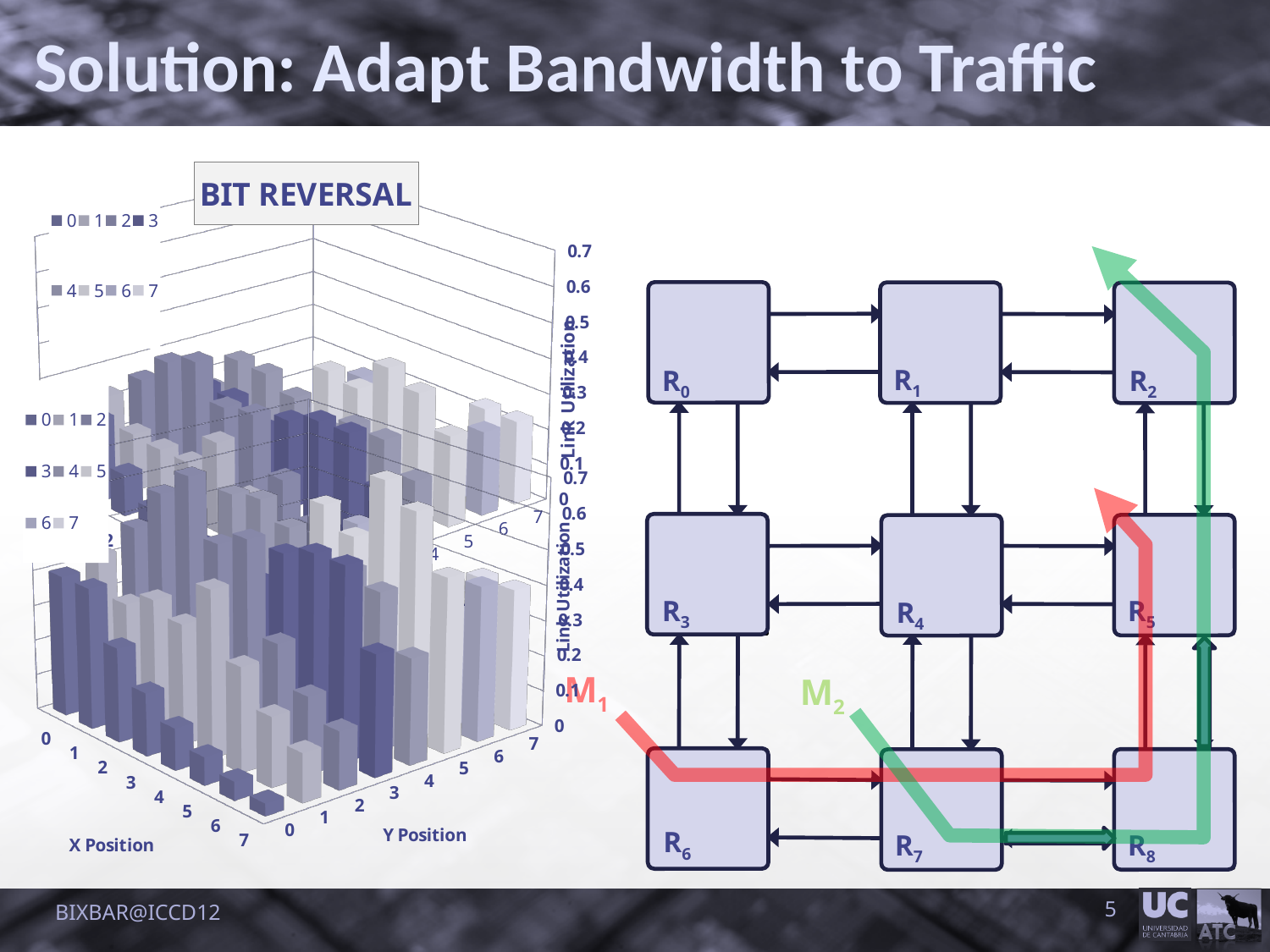
What is the highest tick value shown on the Link Utilization axis of the lower 3D bar chart? 0.7 How many series does the legend of the BIT REVERSAL chart list? 8 What is the title of the upper 3D bar chart on the left of the slide? BIT REVERSAL What kind of chart is the chart titled BIT REVERSAL? bar chart How many X Position categories are shown on the lower 3D bar chart? 8 What is the label of the vertical axis on the lower 3D bar chart? Link Utilization How many Y Position categories are shown on the lower 3D bar chart? 8